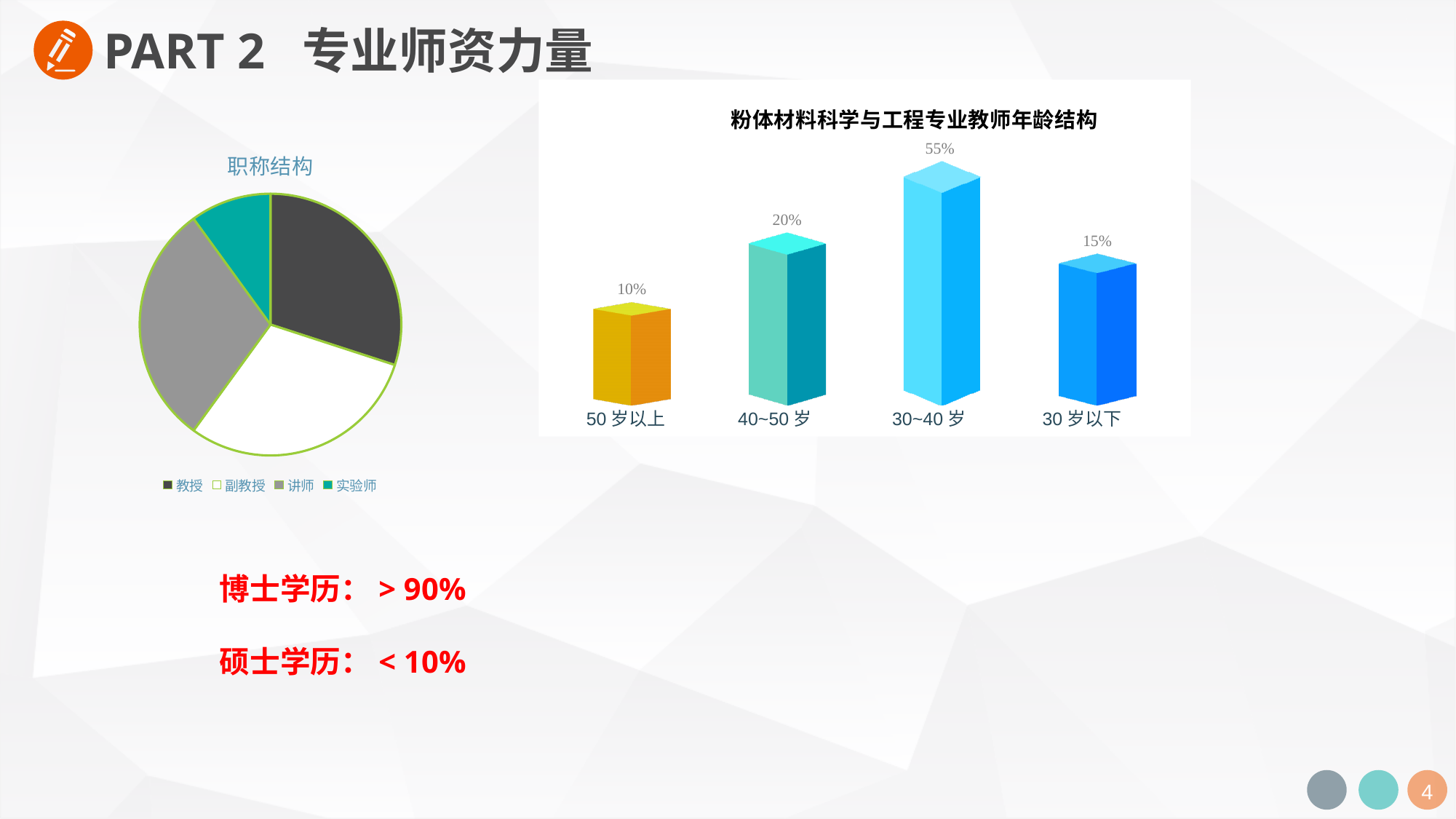
In the pie chart titled 职称结构, which category has the smallest slice? 实验师 In the bar chart titled 粉体材料科学与工程专业教师年龄结构, which age group has the lowest value? 50 岁以上 In the bar chart titled 粉体材料科学与工程专业教师年龄结构, what is the difference between the values for 30~40 岁 and 40~50 岁? 35% How many age groups are shown in the bar chart titled 粉体材料科学与工程专业教师年龄结构? 4 In the bar chart titled 粉体材料科学与工程专业教师年龄结构, what is the value for 30 岁以下? 15% In the bar chart titled 粉体材料科学与工程专业教师年龄结构, which age group has the highest value? 30~40 岁 In the bar chart titled 粉体材料科学与工程专业教师年龄结构, what is the value for 50 岁以上? 10% How many categories does the legend of the pie chart titled 职称结构 list? 4 In the bar chart titled 粉体材料科学与工程专业教师年龄结构, what is the value for 30~40 岁? 55% In the bar chart titled 粉体材料科学与工程专业教师年龄结构, which is larger, the value for 40~50 岁 or the value for 30 岁以下? 40~50 岁 What kind of chart is the chart titled 职称结构 on the left of the slide? pie chart What kind of chart is the chart titled 粉体材料科学与工程专业教师年龄结构? bar chart